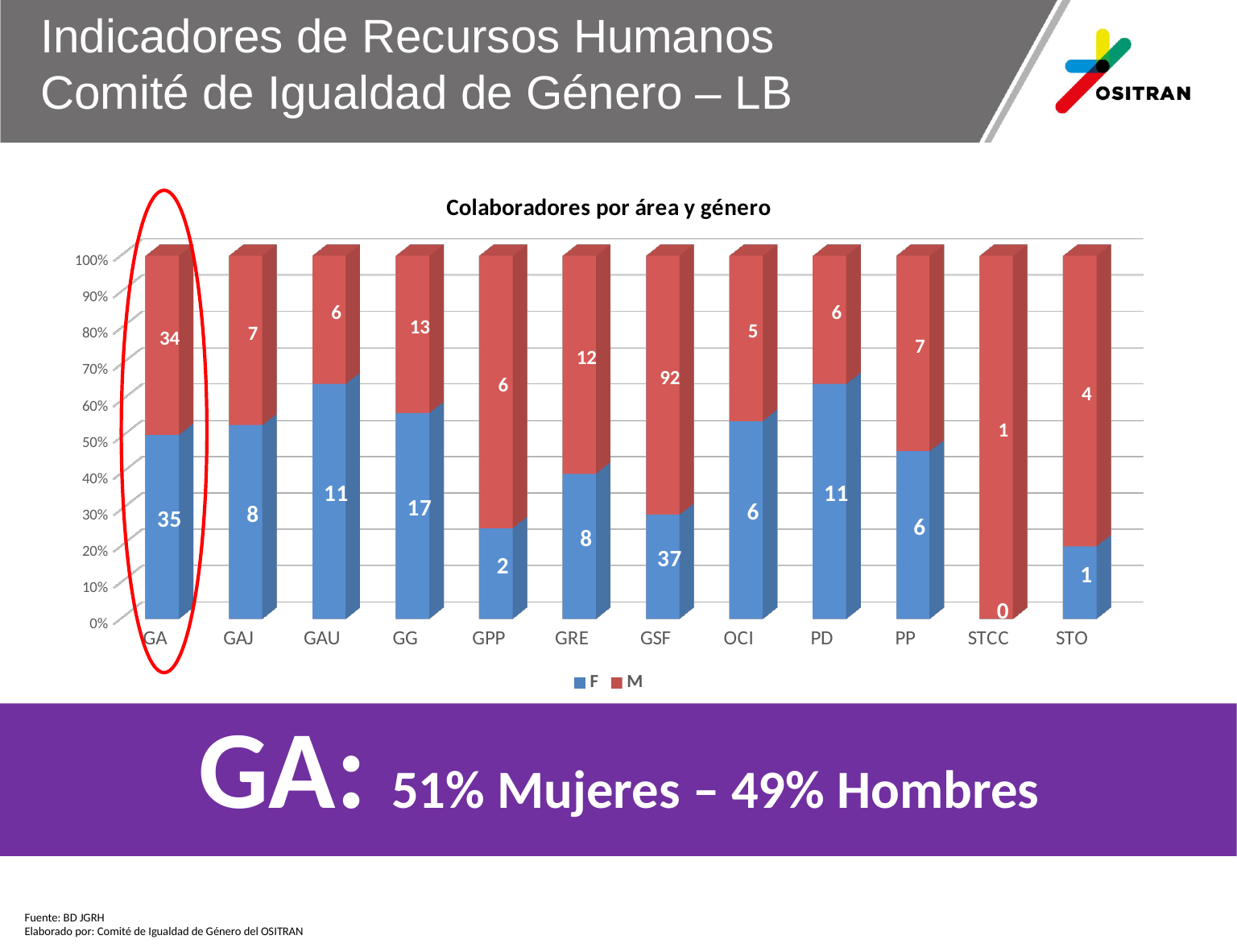
What is the F value for STCC? 0 What is the title of the chart? Colaboradores por área y género Which is larger for GRE, the F value or the M value? M What is the M value for GA in the chart? 34 What is the difference between the F and M values for GG? 4 Which area has the lowest F value? STCC What kind of chart is shown on the slide? Stacked bar chart What is the total number of collaborators (F plus M) for GA? 69 Which area has the highest M value? GSF What is the F value for GSF in the 'Colaboradores por área y género' chart? 37 How many series does the legend list? 2 How many areas are shown on the x axis of the chart? 12